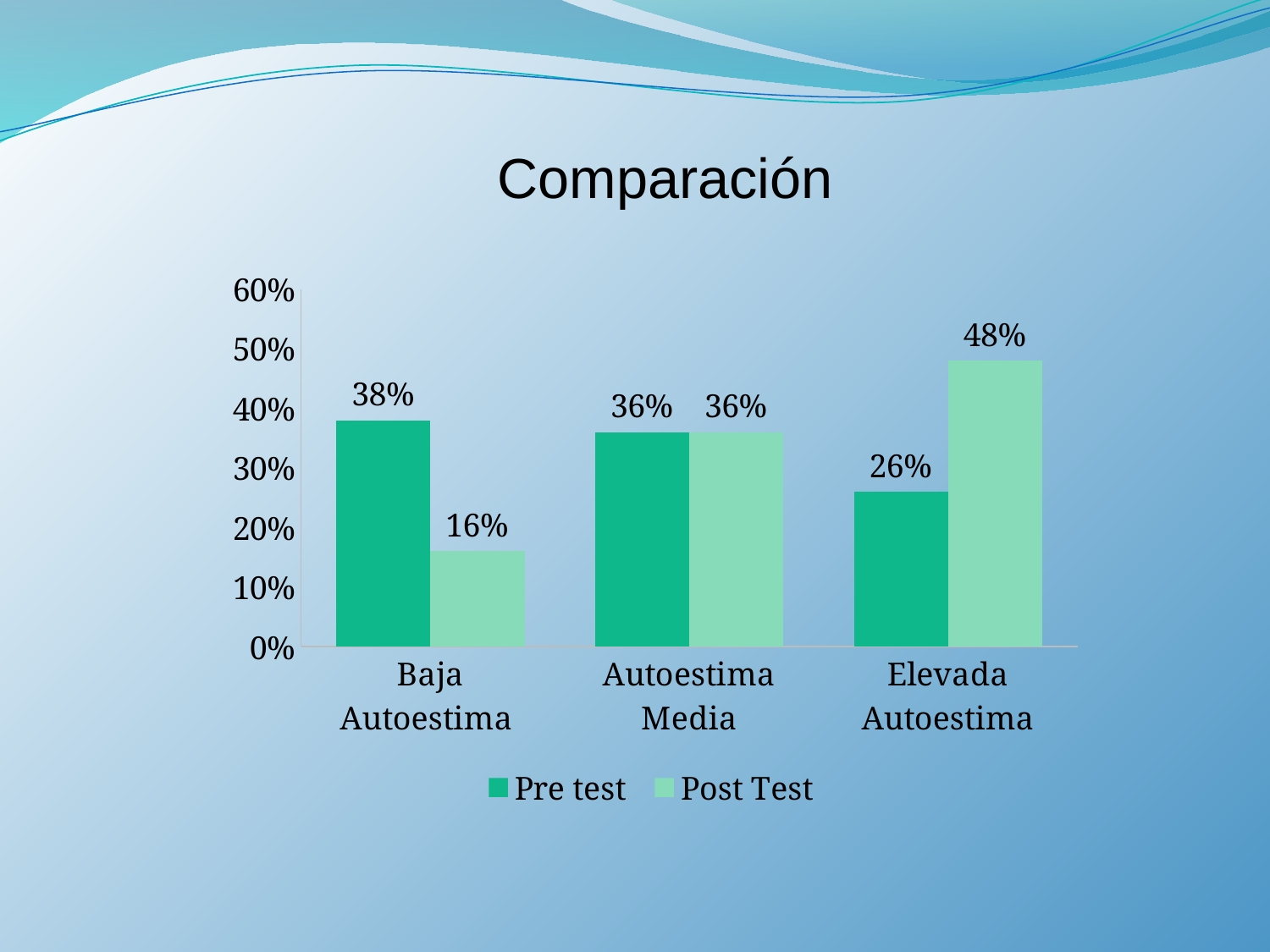
Which category has the lowest Pre test value? Elevada Autoestima What is the Post Test value for Baja Autoestima? 16% What is the Pre test value for Baja Autoestima? 38% Which is larger for Elevada Autoestima, the Pre test value or the Post Test value? Post Test What is the difference between the Pre test and Post Test values for Baja Autoestima? 22% What kind of chart is shown on the slide? Bar chart How many series does the legend list? 2 Which category has the highest Post Test value? Elevada Autoestima What is the title of the chart? Comparación How many categories are shown on the x axis? 3 What is the difference between the Post Test and Pre test values for Elevada Autoestima? 22% What is the Post Test value for Elevada Autoestima? 48%